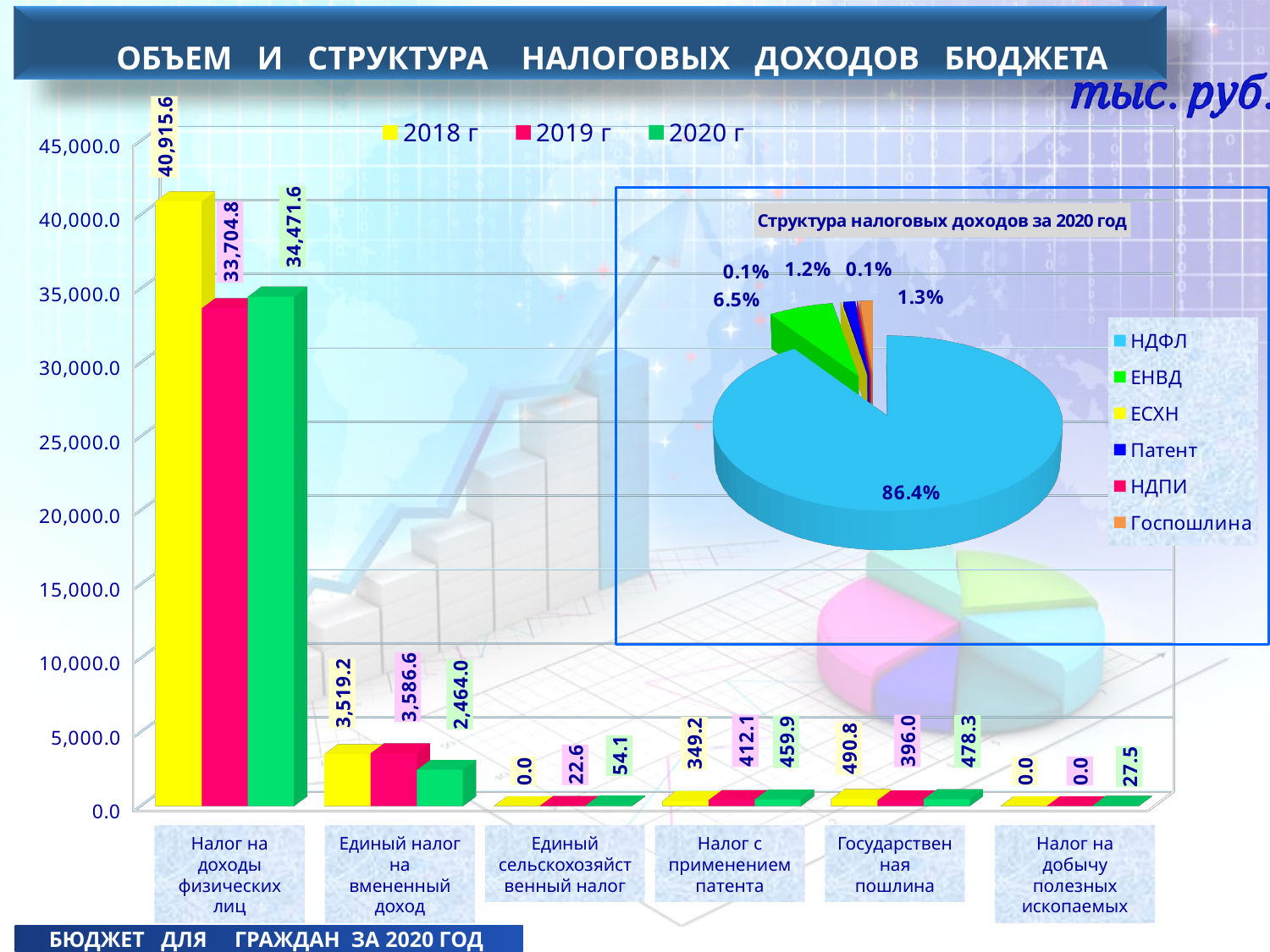
What type of chart is the chart on the left side of the slide? Bar chart In the bar chart, what is the 2019 value for Государственная пошлина? 396.0 In the bar chart, what is the 2020 value for Единый налог на вмененный доход? 2,464.0 In the bar chart, which category has the highest 2020 value? Налог на доходы физических лиц How many categories are shown on the x axis of the bar chart? 6 In the bar chart, what is the difference between the 2018 and 2019 values for Налог на доходы физических лиц? 7,210.8 In the bar chart, which is larger for Налог с применением патента: the 2018 value or the 2020 value? 2020 value In the bar chart, what is the 2018 value for Налог на доходы физических лиц? 40,915.6 In the bar chart, what is the 2020 value for Налог на добычу полезных ископаемых? 27.5 How many series does the legend of the bar chart list? 3 In the pie chart Структура налоговых доходов за 2020 год, what share does НДФЛ have? 86.4% In the pie chart Структура налоговых доходов за 2020 год, what share does ЕНВД have? 6.5%